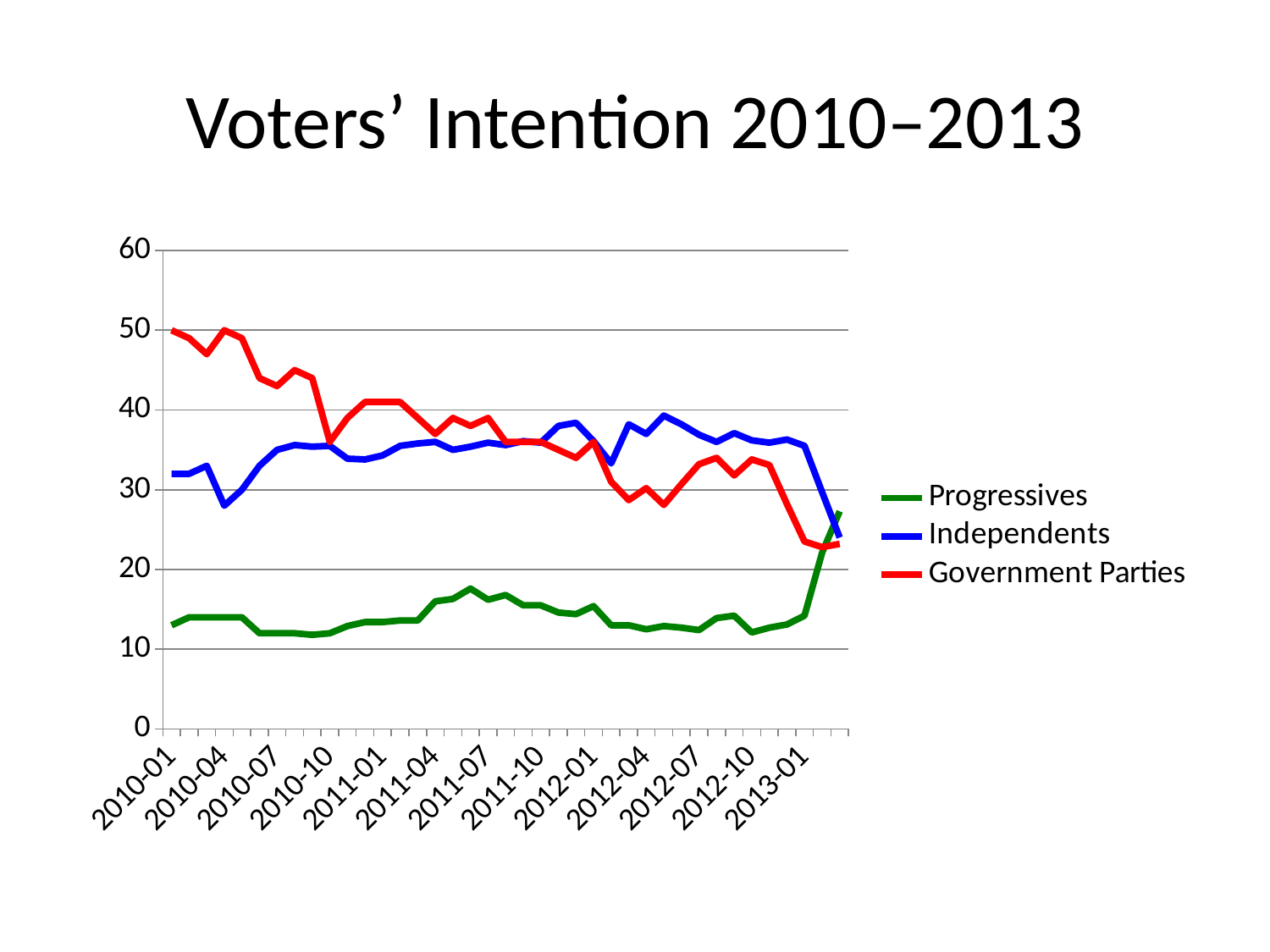
Does the Government Parties series generally rise or fall from 2010-01 to 2013-01? fall Is the value for Independents at 2010-01 greater or less than 30? greater How many series does the legend list? 3 What kind of chart is shown on the slide? line chart What is the title of the chart? Voters' Intention 2010–2013 At 2012-04, which is higher: Independents or Government Parties? Independents Is the value for Government Parties at 2010-04 greater or less than 40? greater Which colour represents the Government Parties series? red Is the value for Progressives at 2010-01 greater or less than 20? less At 2010-01, which is higher: Government Parties or Independents? Government Parties